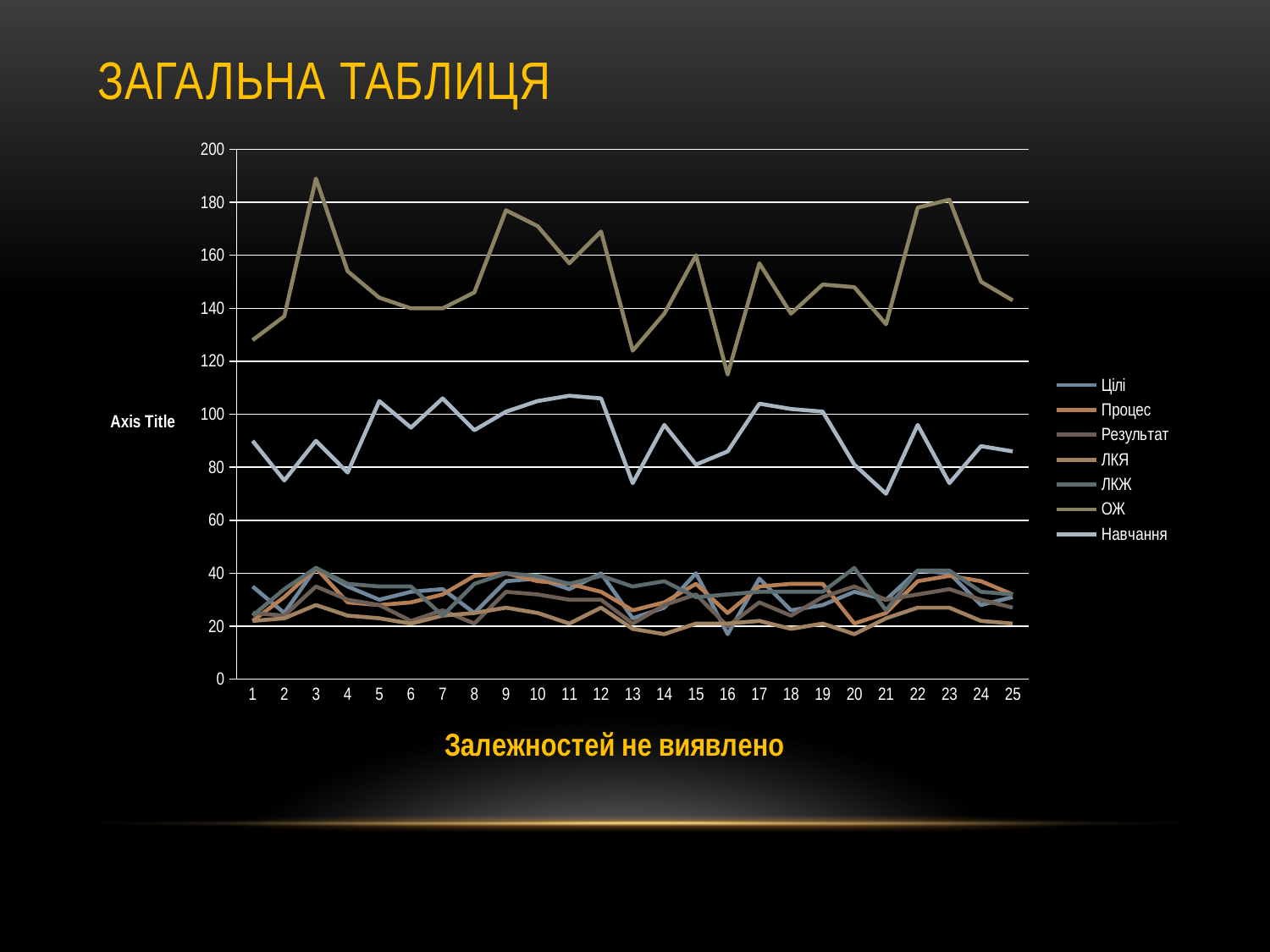
How many points are plotted along the x axis? 25 Which is larger: the value for ОЖ at point 3 or at point 16? point 3 Is the value for ОЖ at point 13 greater or less than 140? less Which series has the highest values across the chart? ОЖ Is the value for Навчання at point 21 greater or less than 80? less How many series does the legend list? 7 At which x-axis point does the ОЖ series reach its highest value? 3 At which x-axis point does the ОЖ series reach its lowest value? 16 Is the value for Навчання at point 11 greater or less than 100? greater What text is shown as the vertical axis title? Axis Title What kind of chart is shown on the slide? line chart